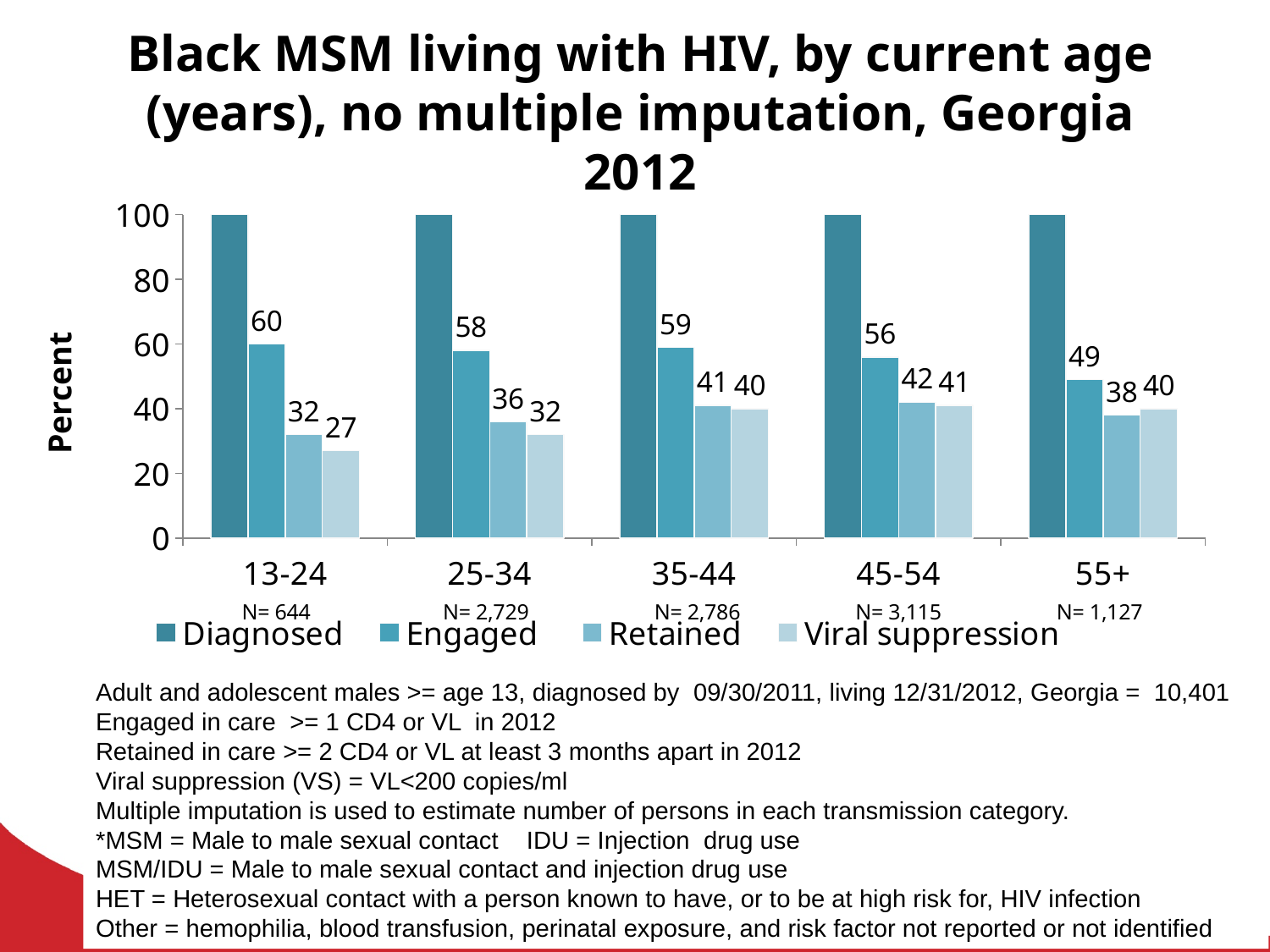
What is the difference between the Engaged and Retained values for the 25-34 age group? 22 How many series does the legend list? 4 Which age group has the lowest Engaged value? 55+ What is the Retained value for the 45-54 age group? 42 What is the Engaged value for the 13-24 age group? 60 Does the Engaged value rise or fall from the 45-54 group to the 55+ group? Fall What kind of chart is shown on the slide? Bar chart What is the Viral suppression value for the 55+ age group? 40 How many age groups are shown on the x axis? 5 Which age group has the lowest Viral suppression value? 13-24 What is the label on the y axis? Percent Is the Retained value larger for the 13-24 group or the 35-44 group? 35-44